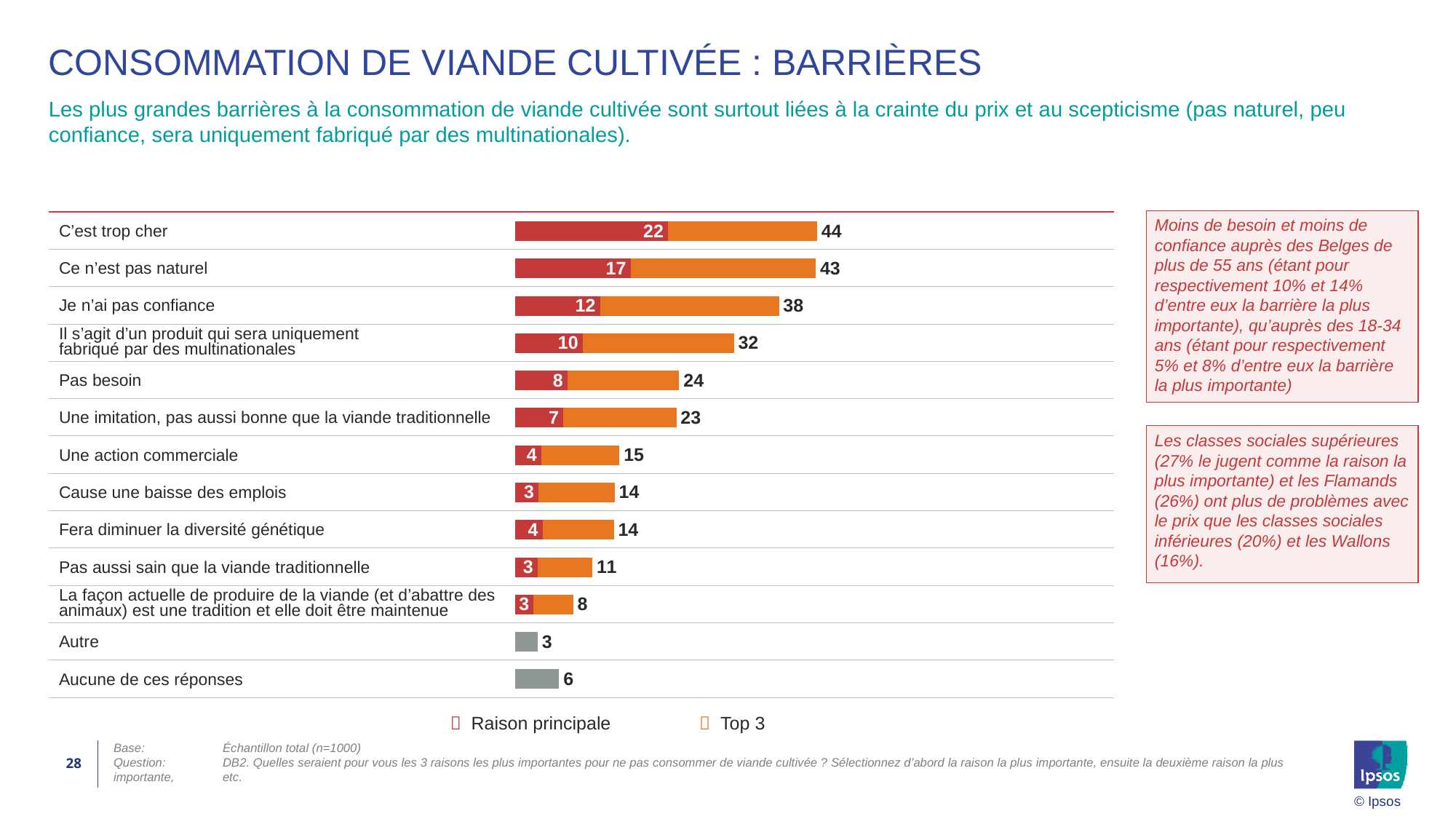
Which has a larger "Raison principale" value: "Une action commerciale" or "Une imitation, pas aussi bonne que la viande traditionnelle"? Une imitation, pas aussi bonne que la viande traditionnelle What is the "Raison principale" value for "Ce n'est pas naturel"? 17 Which category has the lowest Top 3 value among the red/orange bars? La façon actuelle de produire de la viande (et d'abattre des animaux) est une tradition et elle doit être maintenue What is the Top 3 value for "Pas besoin"? 24 How many series does the legend list? 2 What is the Top 3 value for "C'est trop cher"? 44 What is the difference between the Top 3 values for "Je n'ai pas confiance" and "Pas besoin"? 14 What kind of chart is shown on the slide? Bar chart What is the "Raison principale" value for "Il s'agit d'un produit qui sera uniquement fabriqué par des multinationales"? 10 What are the two legend entries of the chart? Raison principale and Top 3 How many categories are shown in the chart? 13 Which category has the highest Top 3 value? C'est trop cher